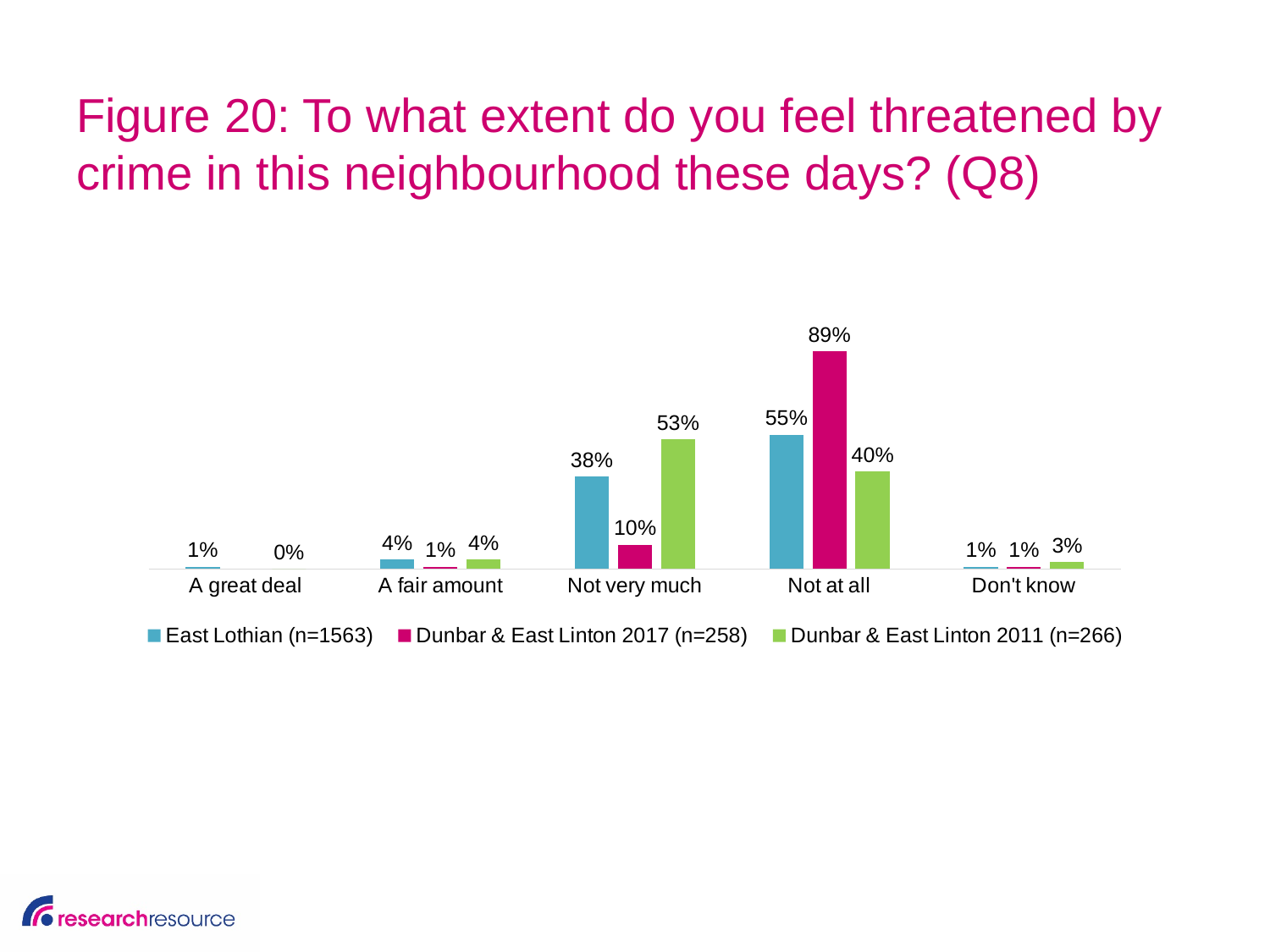
Which response category has the highest value for Dunbar & East Linton 2017? Not at all What is the difference between the Dunbar & East Linton 2017 and Dunbar & East Linton 2011 values for "Not at all"? 49% For "Not at all", which is larger: the East Lothian value or the Dunbar & East Linton 2011 value? East Lothian How many response categories are shown on the x axis? 5 What percentage of Dunbar & East Linton 2011 respondents answered "Not very much"? 53% What is the East Lothian value for "Not very much"? 38% How many series does the legend list? 3 What percentage of Dunbar & East Linton 2017 respondents answered "Not at all"? 89% What type of chart is shown on the slide? Bar chart Which response category has the highest value for Dunbar & East Linton 2011? Not very much What is the difference between the East Lothian and Dunbar & East Linton 2017 values for "Not very much"? 28%